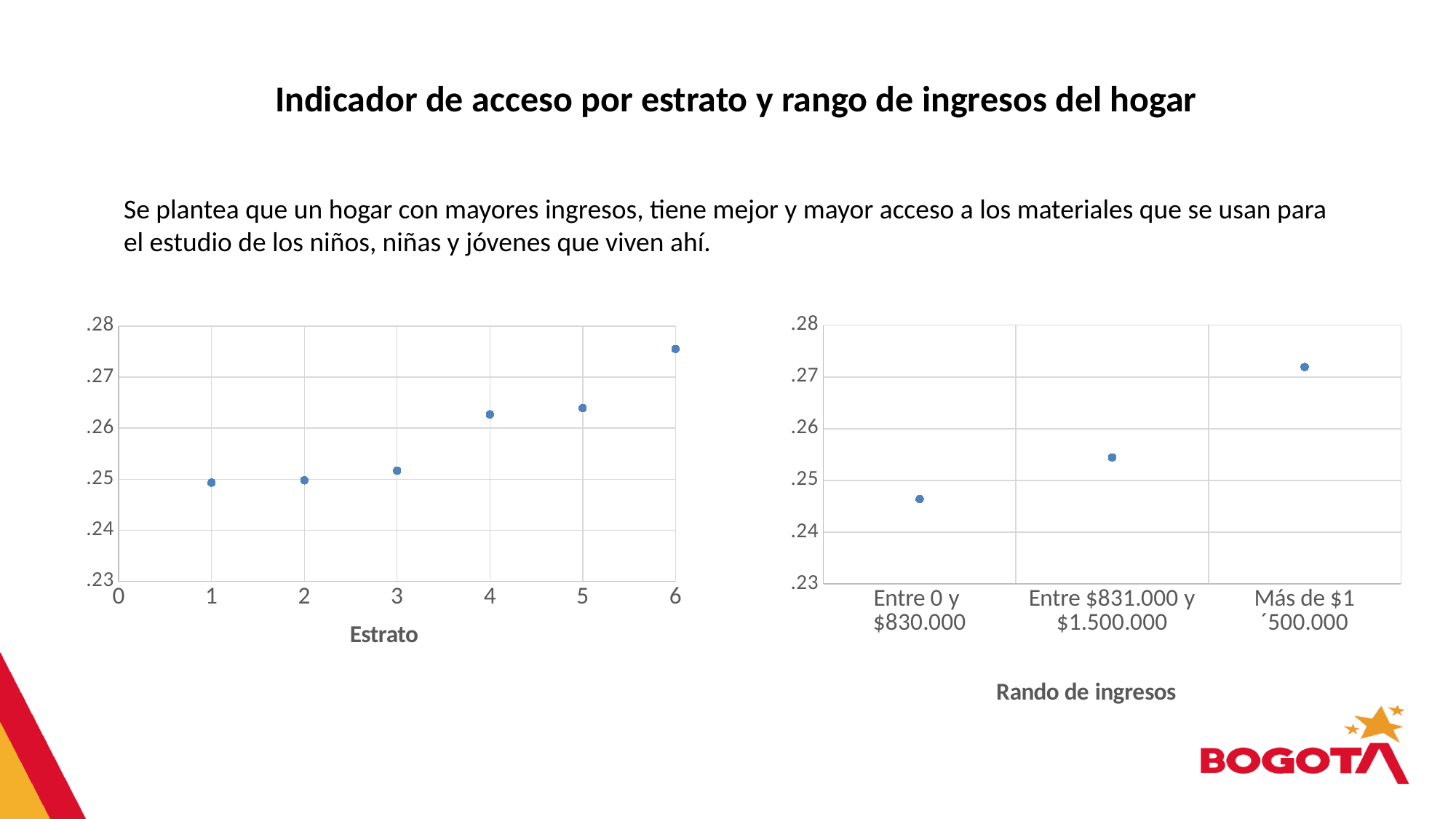
On the left chart (Estrato), is the value for estrato 4 greater or less than .26? greater What kind of chart is the left chart (Estrato)? scatter chart On the right chart (Rando de ingresos), which income range has the lowest access indicator value? Entre 0 y $830.000 On the left chart (Estrato), which is larger, the value for estrato 3 or the value for estrato 4? estrato 4 On the left chart (Estrato), do the values generally rise or fall as the estrato increases? rise On the right chart (Rando de ingresos), how many income ranges are plotted? 3 On the left chart (Estrato), which estrato has the highest access indicator value? 6 On the left chart (Estrato), is the value for estrato 2 greater or less than .26? less On the right chart (Rando de ingresos), which income range has the highest access indicator value? Más de $1´500.000 On the right chart (Rando de ingresos), is the value for 'Entre 0 y $830.000' greater or less than .25? less On the left chart (Estrato), how many data points are plotted? 6